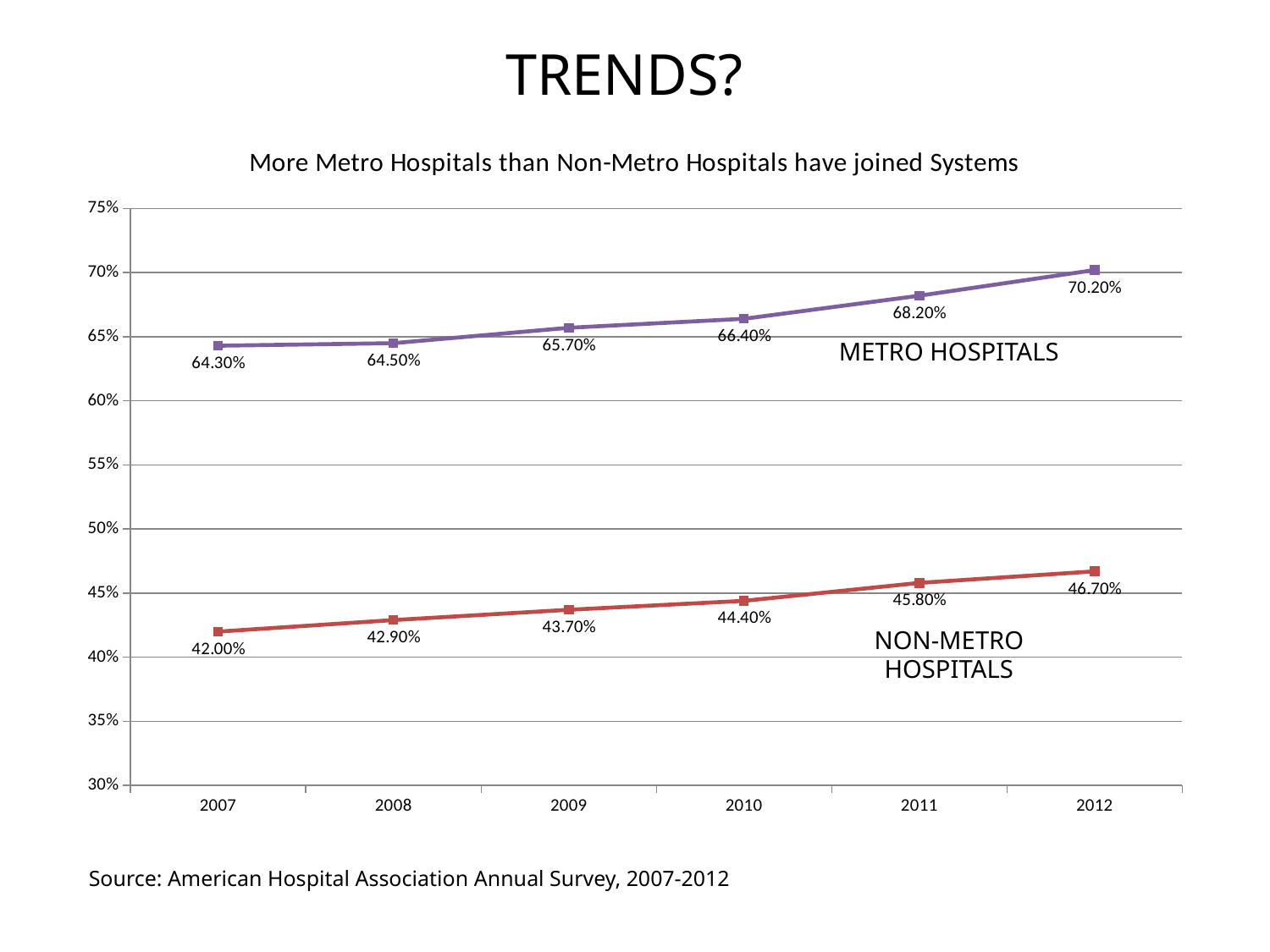
In which year is the Non-Metro Hospitals value lowest? 2007 What is the value for Non-Metro Hospitals in 2007? 42.00% In which year is the Metro Hospitals value highest? 2012 What kind of chart is shown on the slide? Line chart What is the value for Non-Metro Hospitals in 2011? 45.80% Which is larger in 2010: the Metro Hospitals value or the Non-Metro Hospitals value? Metro Hospitals What is the value for Metro Hospitals in 2009? 65.70% Do the Non-Metro Hospitals values rise or fall from 2007 to 2012? Rise How many years are plotted on the x axis? 6 What is the value for Metro Hospitals in 2012? 70.20% How many series are plotted on the chart? 2 What is the difference between the Metro Hospitals and Non-Metro Hospitals values in 2012? 23.50%